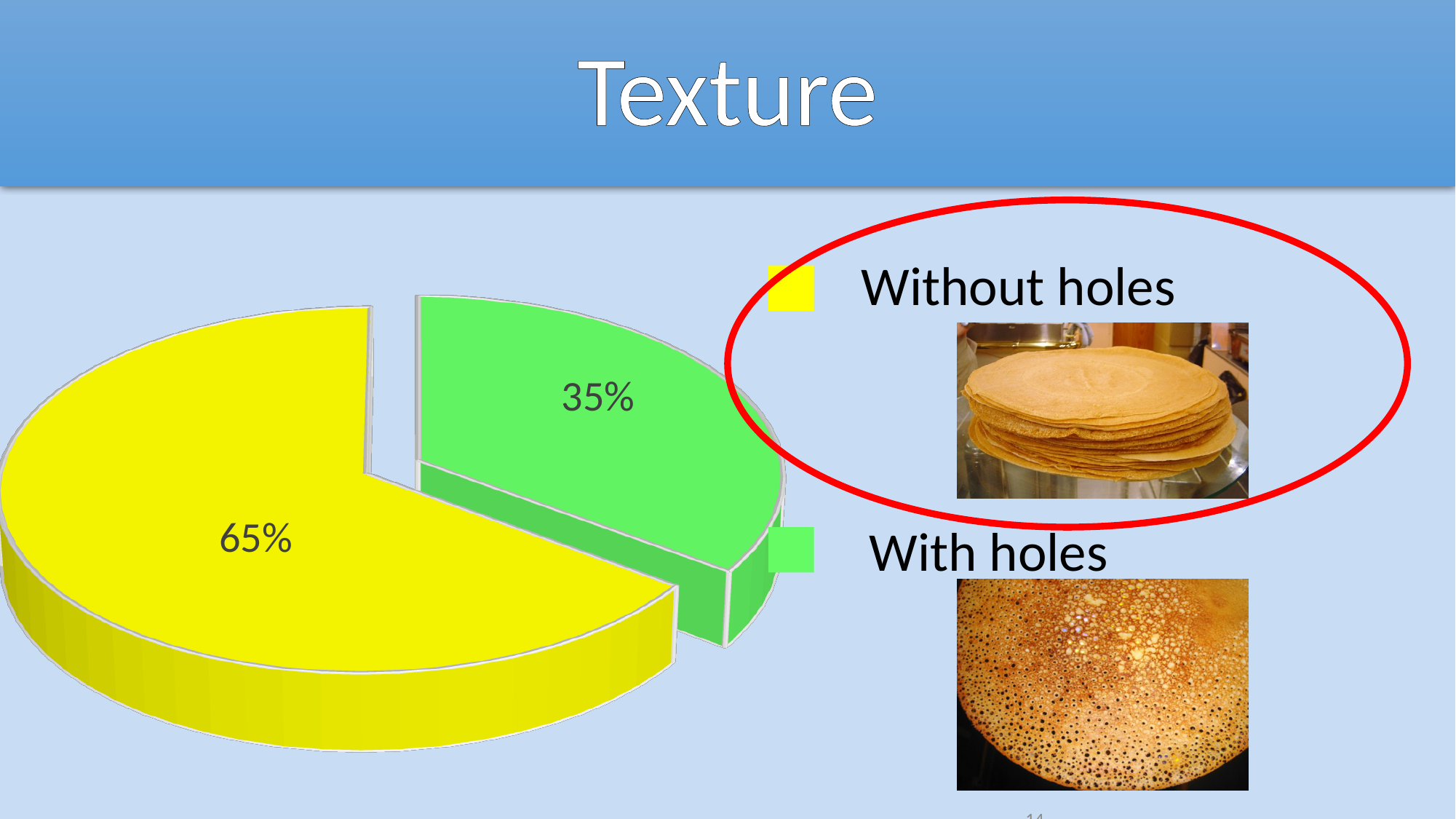
What is the difference in percentage points between the "Without holes" and "With holes" slices? 30 Which category has the smallest slice of the pie? With holes How many slices does the pie chart have? 2 What is the title of the slide containing the pie chart? Texture What kind of chart is shown on the slide? Pie chart What is the total of the two slice percentages shown on the pie? 100% What share of the pie is labelled "With holes"? 35% Which category has the largest slice of the pie? Without holes Which slice is larger, "Without holes" or "With holes"? Without holes What colour is the "With holes" slice? Green What share of the pie is labelled "Without holes"? 65%